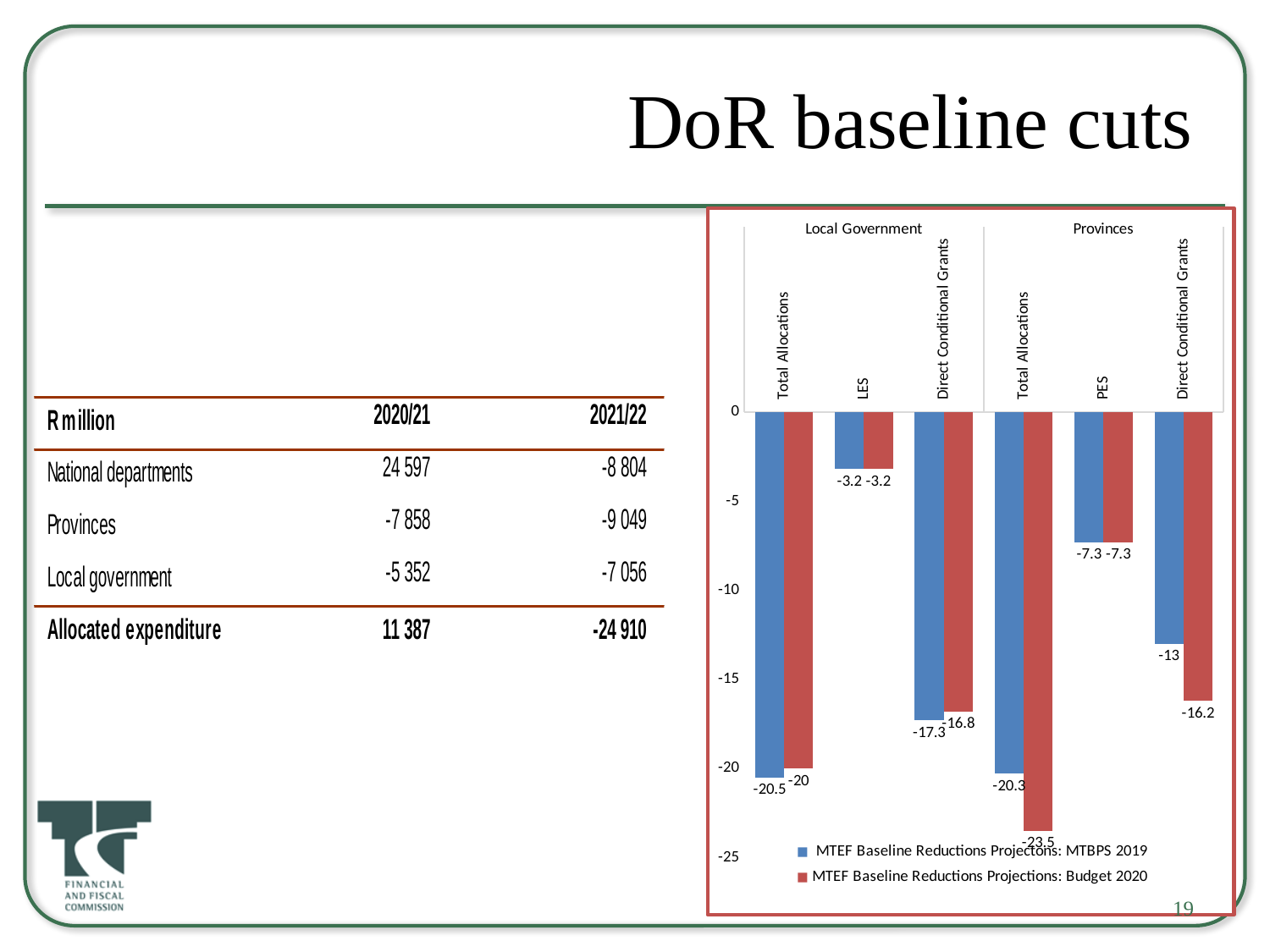
What is the MTBPS 2019 value for Total Allocations under Local Government? -20.5 Which category has the lowest (most negative) Budget 2020 value? Total Allocations (Provinces) Which category has the highest (least negative) MTBPS 2019 value? LES What is the MTBPS 2019 value for LES under Local Government? -3.2 For Direct Conditional Grants under Local Government, which series has the more negative value, MTBPS 2019 or Budget 2020? MTBPS 2019 What is the Budget 2020 value for Total Allocations under Provinces? -23.5 How many series does the chart legend list? 2 Which series is shown in red in the chart? MTEF Baseline Reductions Projections: Budget 2020 What is the difference between the MTBPS 2019 and Budget 2020 values for Direct Conditional Grants under Provinces? 3.2 How many categories are plotted along the x axis of the chart? 6 What is the Budget 2020 value for Direct Conditional Grants under Provinces? -16.2 What type of chart is shown on the slide? Bar chart